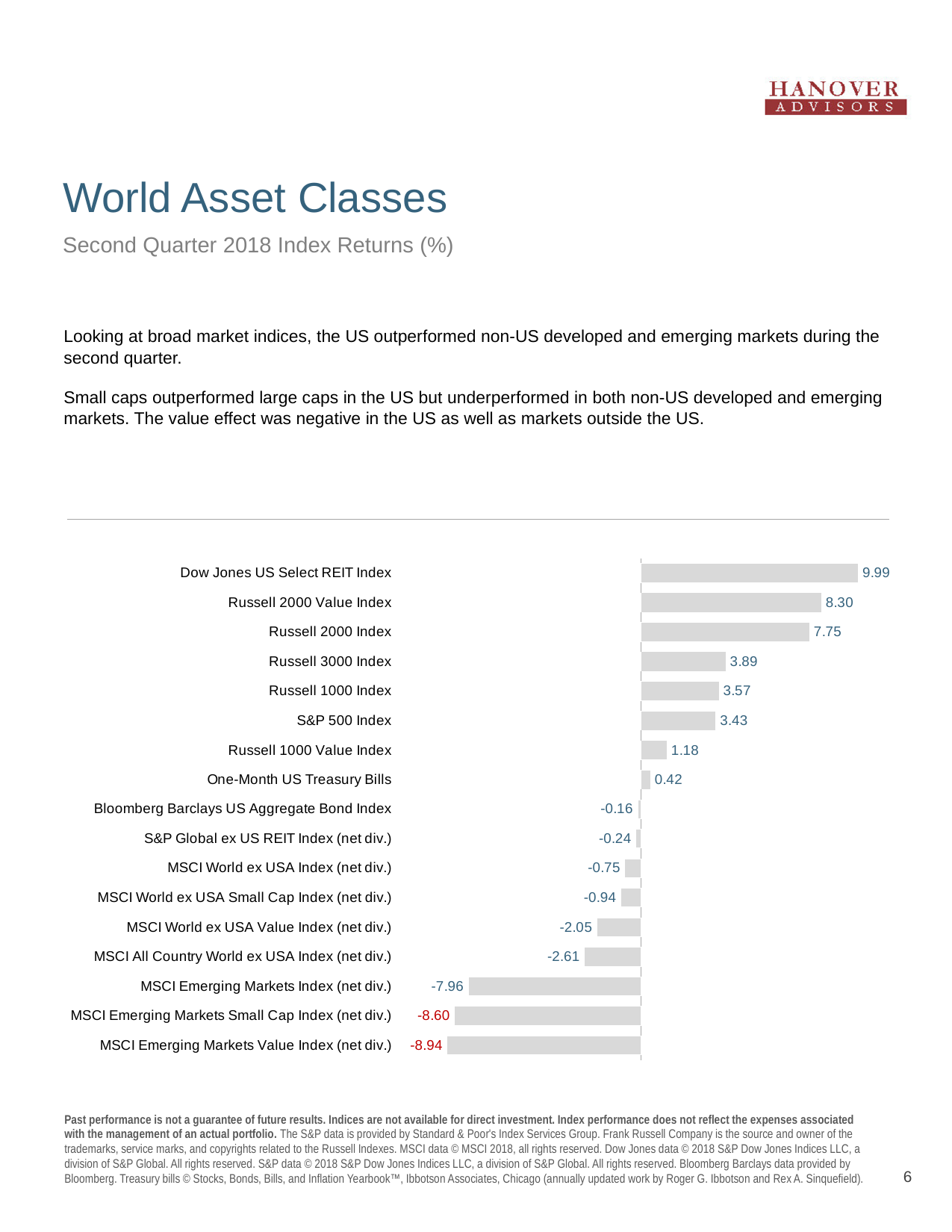
How many indices are shown in the chart? 17 What is the value for the S&P 500 Index? 3.43 What is the difference between the Russell 1000 Index and the Russell 1000 Value Index? 2.39 What is the value for the MSCI Emerging Markets Index (net div.)? -7.96 What is the difference between the Russell 2000 Value Index and the Russell 2000 Index? 0.55 What is the value for the Dow Jones US Select REIT Index? 9.99 What kind of chart is shown on the slide? Bar chart What is the value for One-Month US Treasury Bills? 0.42 Which index has the lowest value? MSCI Emerging Markets Value Index (net div.) What is the subtitle of the slide describing the chart's data? Second Quarter 2018 Index Returns (%) Which index has the highest value? Dow Jones US Select REIT Index Which is larger, the Russell 3000 Index or the Russell 1000 Index? Russell 3000 Index